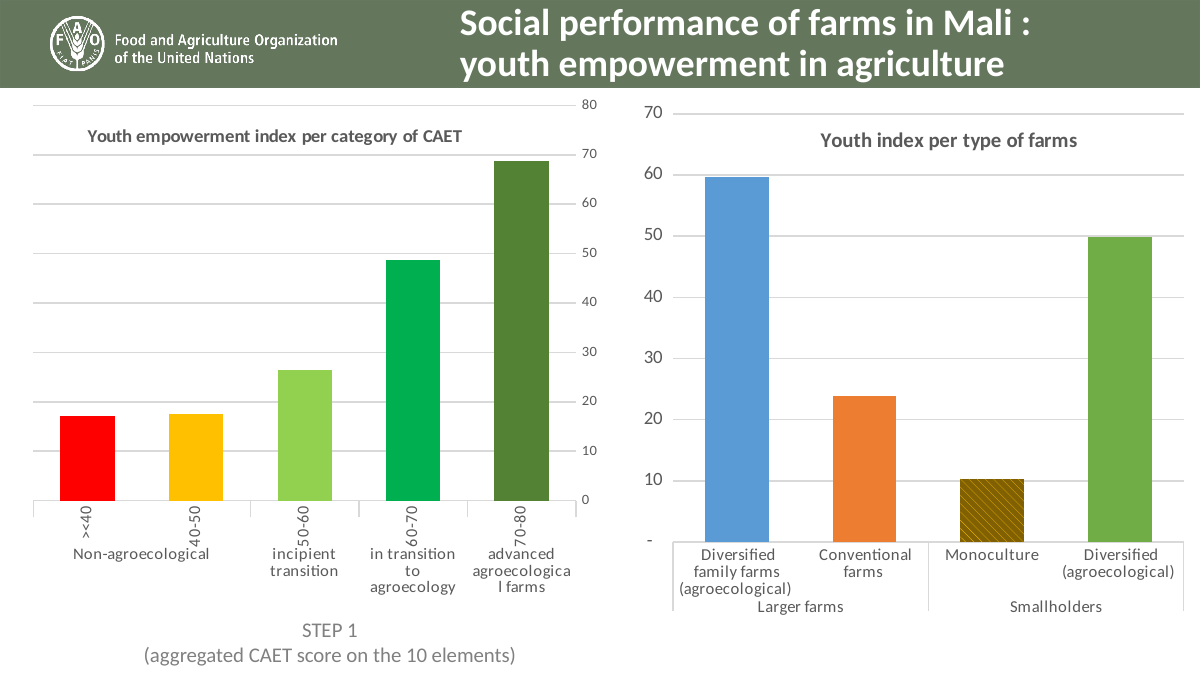
On the chart titled 'Youth empowerment index per category of CAET', do the values rise or fall as the CAET score categories increase from left to right? rise On the chart titled 'Youth empowerment index per category of CAET', is the value for the 50-60 category greater or less than 20? greater On the chart titled 'Youth empowerment index per category of CAET', is the value for the 70-80 category greater or less than 60? greater On the chart titled 'Youth index per type of farms', is the value for Monoculture greater or less than 20? less What kind of chart is the chart titled 'Youth index per type of farms'? bar chart On the chart titled 'Youth index per type of farms', which type of farm has the highest youth index? Diversified family farms (agroecological) On the chart titled 'Youth empowerment index per category of CAET', how many CAET categories are plotted? 5 On the chart titled 'Youth empowerment index per category of CAET', which CAET category has the highest youth empowerment index? 70-80 (advanced agroecological farms) On the chart titled 'Youth index per type of farms', which type of farm has the lowest youth index? Monoculture On the chart titled 'Youth empowerment index per category of CAET', which is larger, the value for 60-70 or the value for 50-60? 60-70